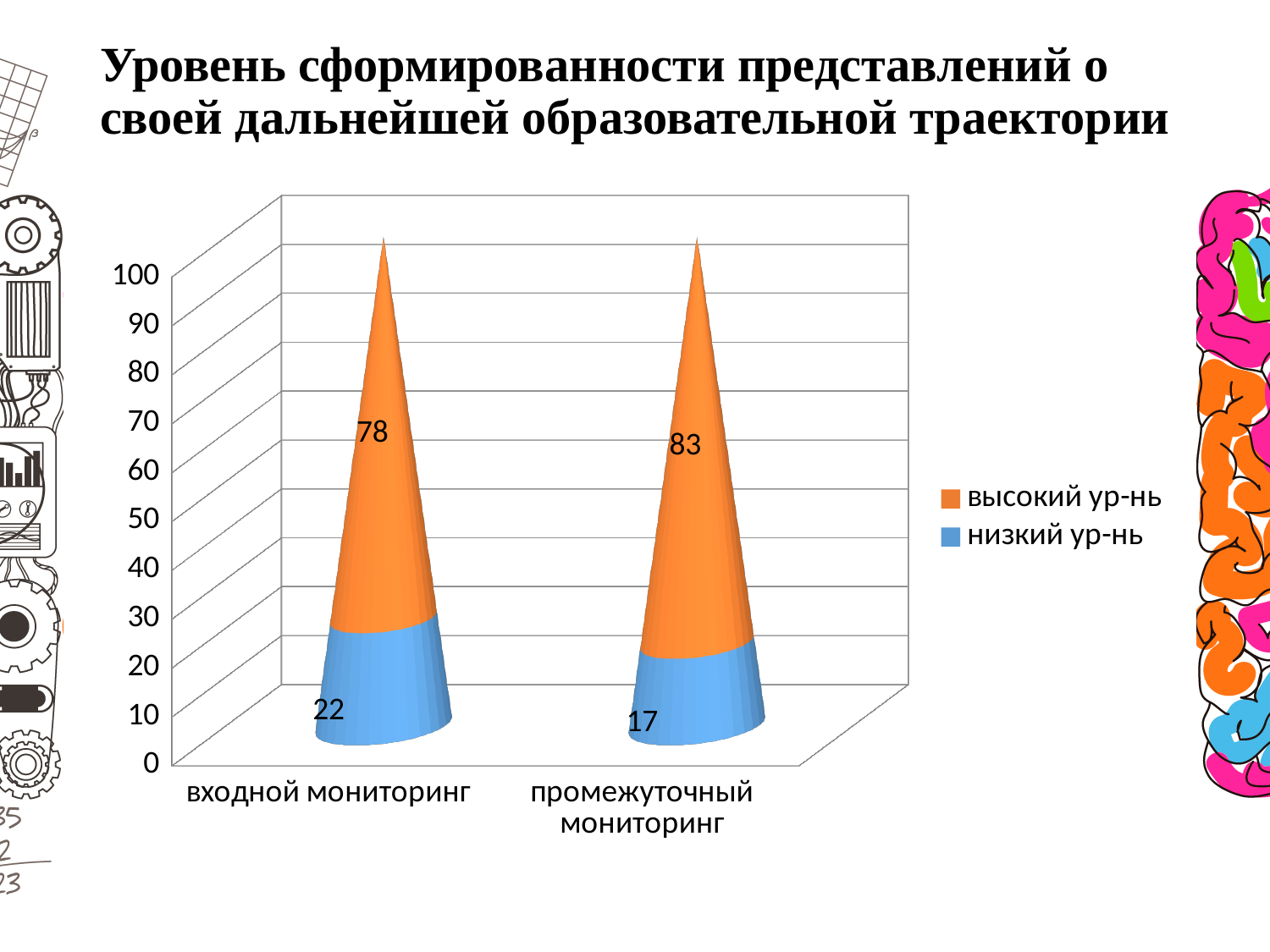
Which is larger: the "низкий ур-нь" value for "входной мониторинг" or for "промежуточный мониторинг"? входной мониторинг What is the total of the stacked bar for "входной мониторинг"? 100 In which category is the "высокий ур-нь" value highest? промежуточный мониторинг What is the value for "низкий ур-нь" in the "входной мониторинг" category? 22 What is the value for "низкий ур-нь" in the "промежуточный мониторинг" category? 17 Which series is shown in orange? высокий ур-нь What is the value for "высокий ур-нь" in the "входной мониторинг" category? 78 What is the difference between the "высокий ур-нь" values for "промежуточный мониторинг" and "входной мониторинг"? 5 How many categories are shown on the x axis? 2 What is the value for "высокий ур-нь" in the "промежуточный мониторинг" category? 83 In which category is the "низкий ур-нь" value lowest? промежуточный мониторинг How many series does the legend list? 2